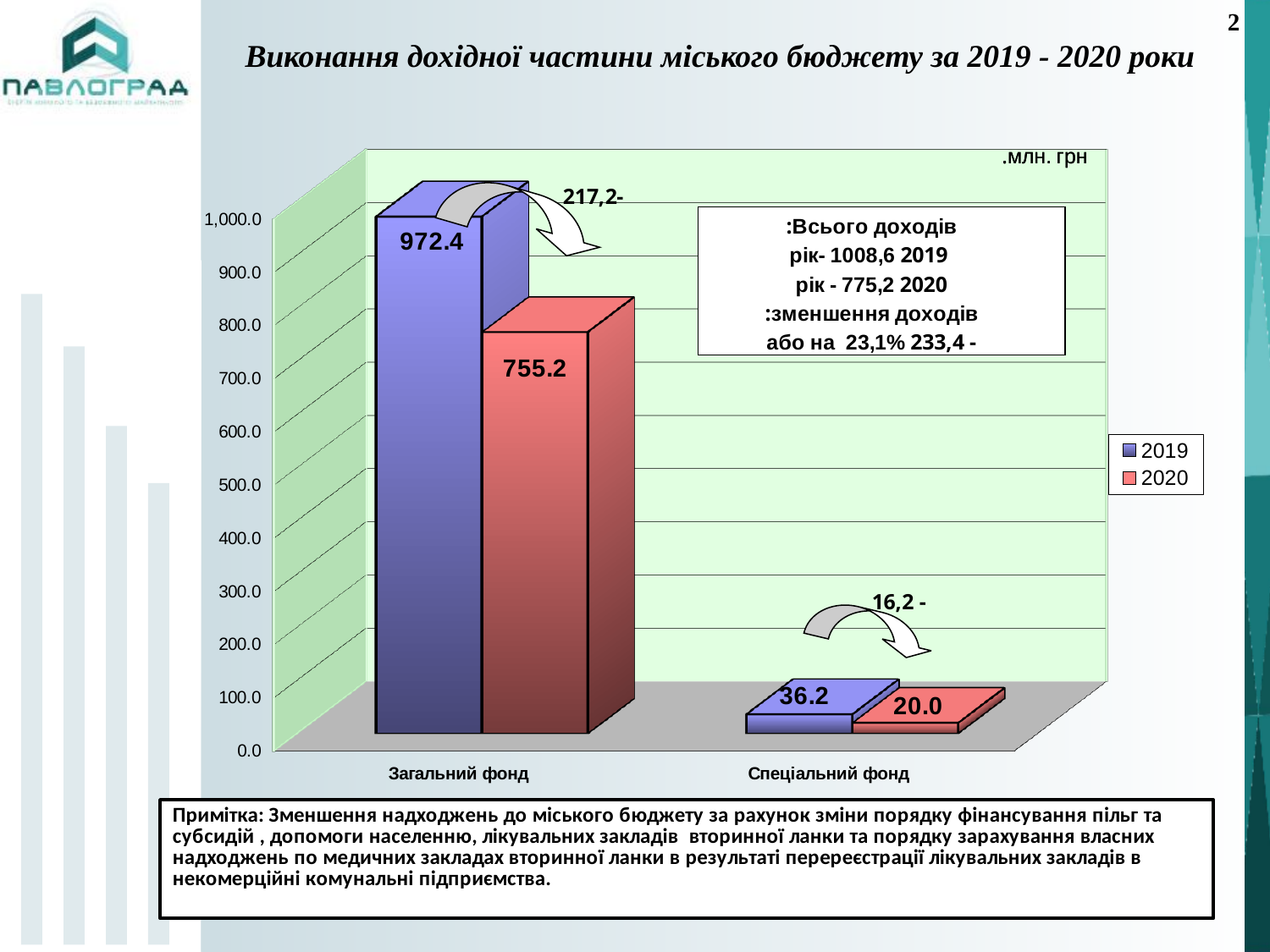
What type of chart is shown on the slide? Bar chart How many series does the legend list? 2 Which is larger: the 2019 value for Загальний фонд or the 2020 value for Загальний фонд? 2019 Which category has the lowest value in the 2020 series? Спеціальний фонд How many categories are shown on the x axis? 2 What is the difference between the 2019 and 2020 values for Загальний фонд? 217.2 What is the value for Загальний фонд in 2020? 755.2 What is the value for Спеціальний фонд in 2020? 20.0 What is the difference between the 2019 and 2020 values for Спеціальний фонд? 16.2 What is the value for Загальний фонд in 2019? 972.4 Which category has the highest value in the 2019 series? Загальний фонд What is the value for Спеціальний фонд in 2019? 36.2